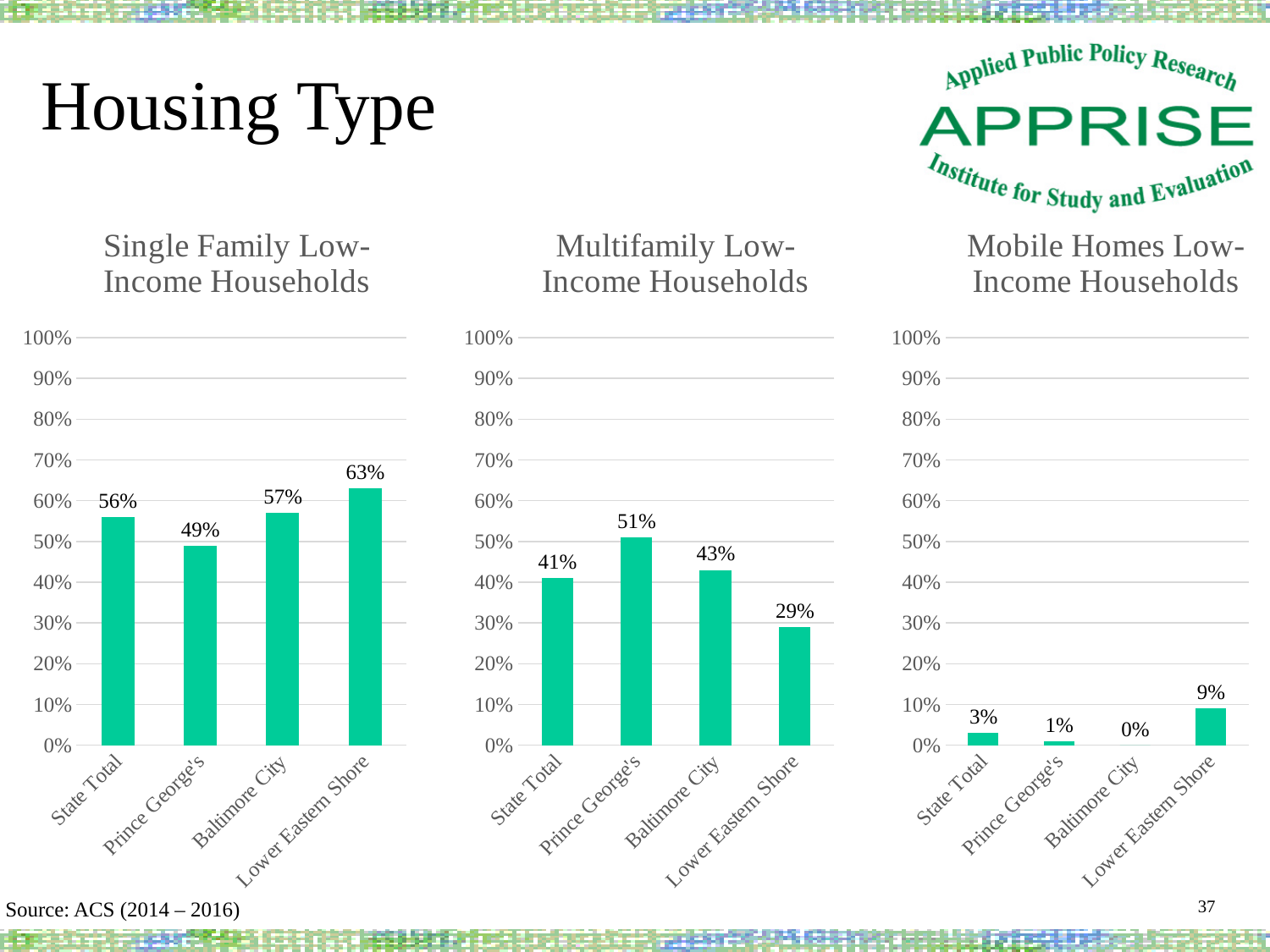
In the Multifamily Low-Income Households chart, what is the value for State Total? 41% In the Multifamily Low-Income Households chart, what is the difference between Prince George's and Lower Eastern Shore? 22% In the Mobile Homes Low-Income Households chart, which category has the highest value? Lower Eastern Shore In the Multifamily Low-Income Households chart, which is larger, Baltimore City or Lower Eastern Shore? Baltimore City In the Single Family Low-Income Households chart, what is the value for Lower Eastern Shore? 63% How many charts are shown on the slide? 3 What kind of chart is the Single Family Low-Income Households chart? Bar chart In the Multifamily Low-Income Households chart, which category has the highest value? Prince George's In the Single Family Low-Income Households chart, what is the difference between Lower Eastern Shore and Prince George's? 14% In the Single Family Low-Income Households chart, which category has the lowest value? Prince George's How many categories are shown in the Mobile Homes Low-Income Households chart? 4 In the Mobile Homes Low-Income Households chart, what is the value for Baltimore City? 0%